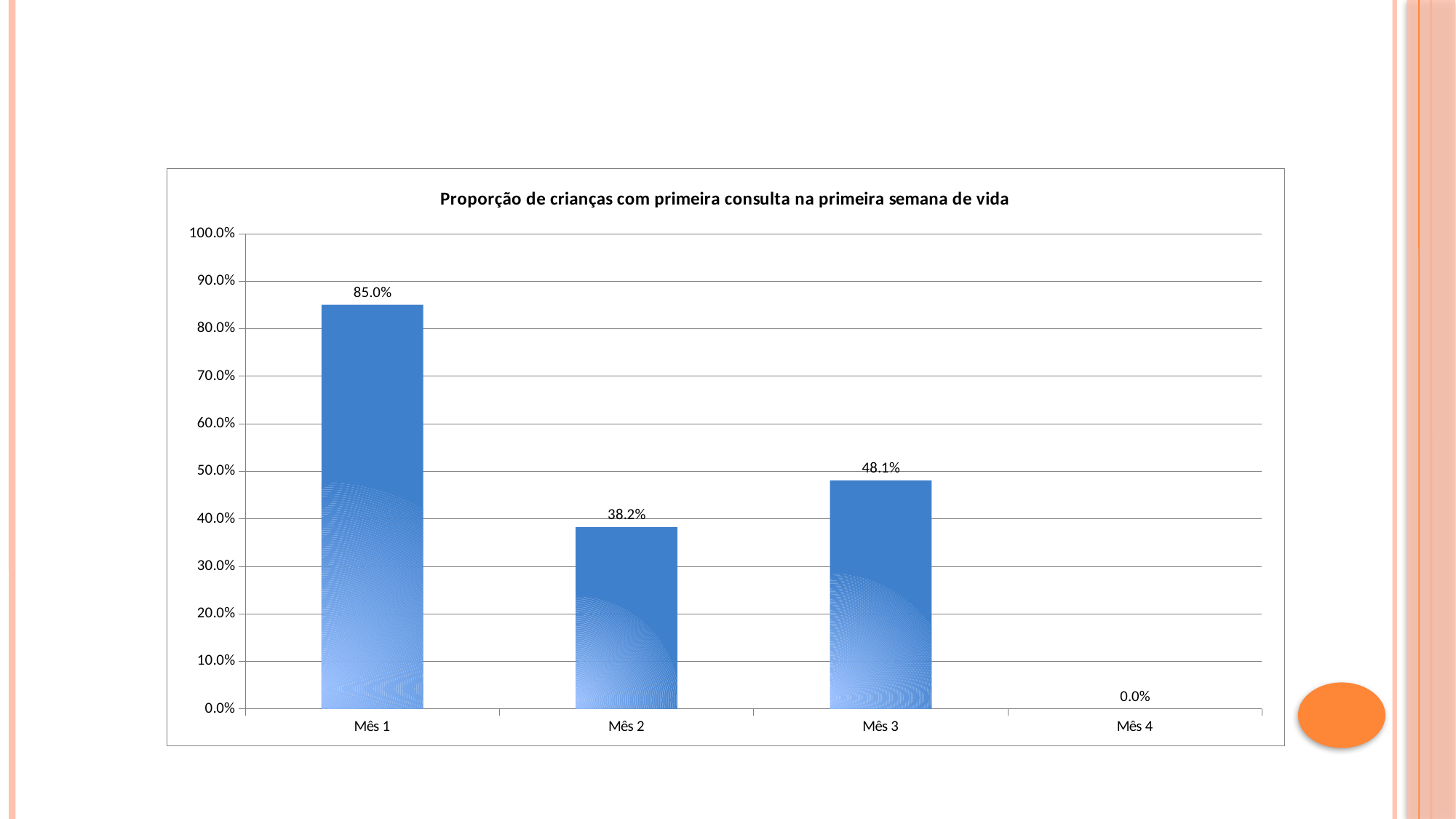
Which is larger, the value for Mês 2 or Mês 3? Mês 3 What is the value for Mês 3? 48.1% What is the value for Mês 1? 85.0% What is the difference between the values for Mês 3 and Mês 2? 9.9% What is the difference between the values for Mês 1 and Mês 2? 46.8% What is the value for Mês 2? 38.2% How many categories are shown on the x axis? 4 What is the value for Mês 4? 0.0% Which month has the lowest value? Mês 4 What kind of chart is shown? Bar chart Which month has the highest value? Mês 1 What is the title of the chart? Proporção de crianças com primeira consulta na primeira semana de vida